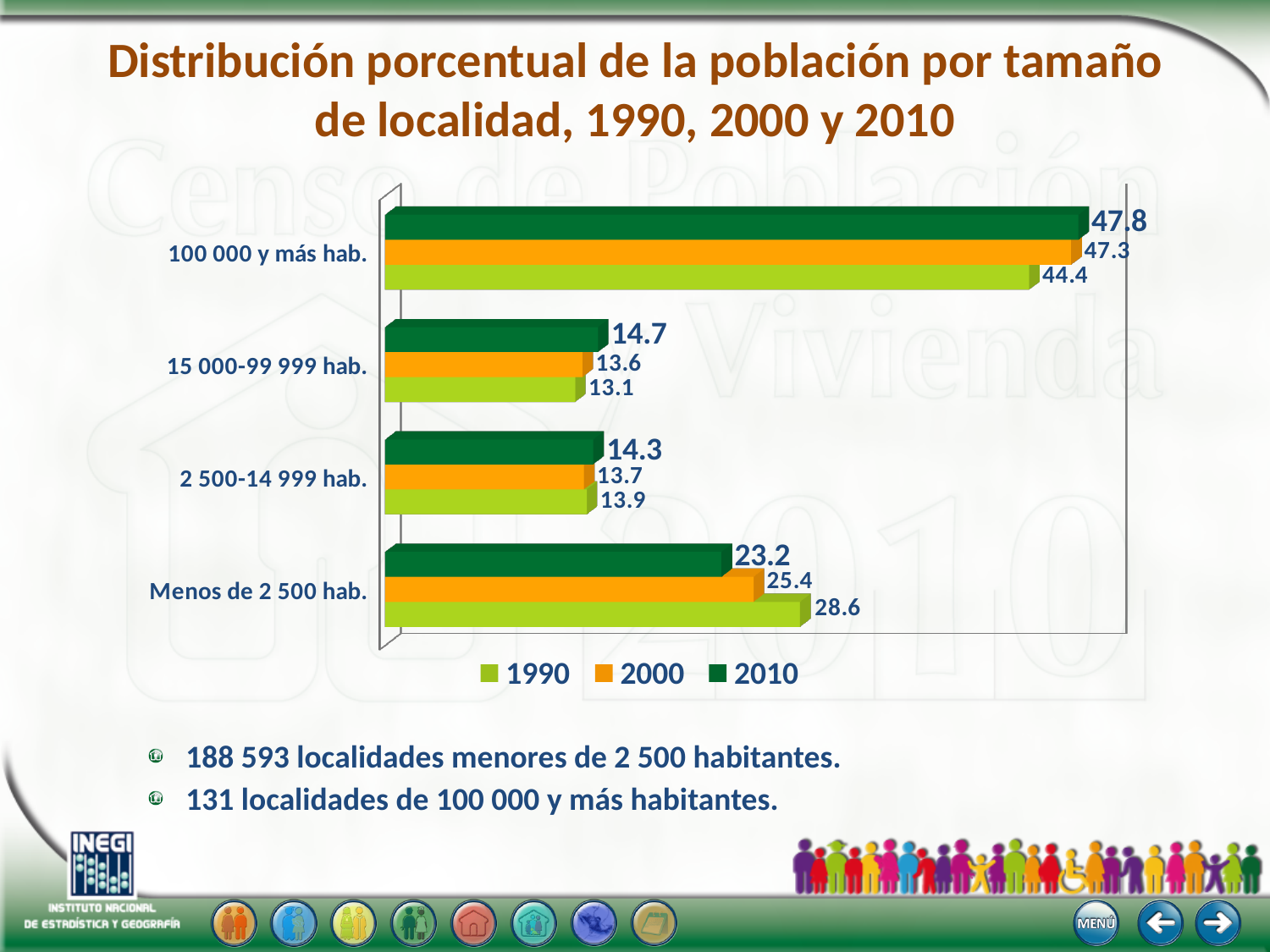
In the '15 000-99 999 hab.' category, which is larger, the 2010 value or the 1990 value? 2010 What is the value for 2000 in the '2 500-14 999 hab.' category? 13.7 What kind of chart is shown on the slide? bar chart Which category has the lowest value for 1990? 15 000-99 999 hab. Which series is shown in orange in the legend? 2000 Does the value for 'Menos de 2 500 hab.' rise or fall from 1990 to 2010? fall What is the value for 2010 in the '100 000 y más hab.' category? 47.8 What is the difference between the 1990 and 2010 values for 'Menos de 2 500 hab.'? 5.4 What is the value for 1990 in the 'Menos de 2 500 hab.' category? 28.6 Which category has the highest value for 2010? 100 000 y más hab. How many series does the legend list? 3 How many locality-size categories are plotted in the chart? 4